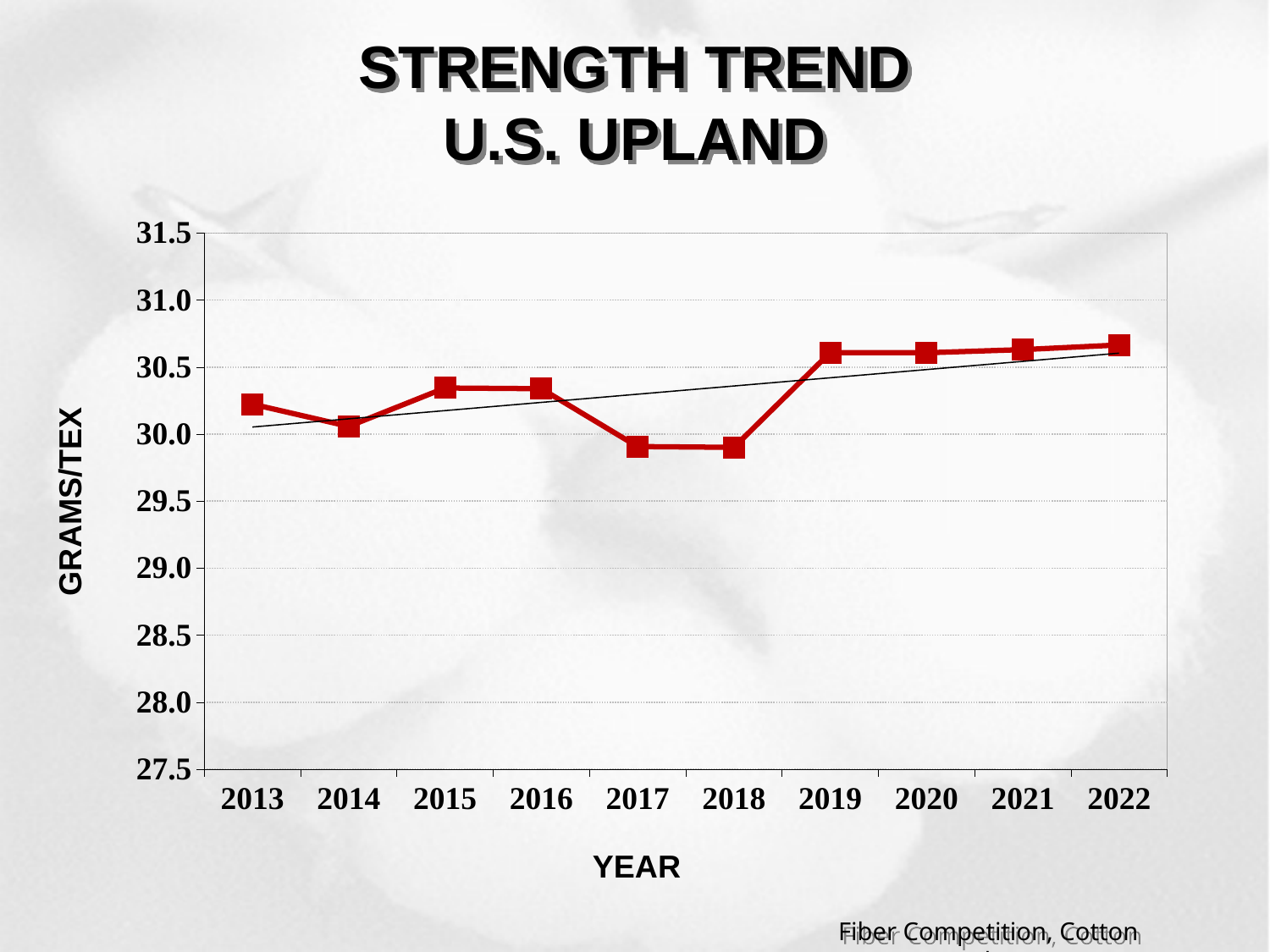
What is the label on the y axis? GRAMS/TEX Is the value for 2019 greater or less than 30.5? greater Which year has the larger value, 2014 or 2019? 2019 Which year has the larger value, 2015 or 2017? 2015 What is the title of the chart? STRENGTH TREND U.S. UPLAND What kind of chart is shown on the slide? line chart Is the value for 2022 greater or less than 30.5? greater Is the value for 2015 greater or less than 30.5? less How many years are plotted on the x axis? 10 Does the overall trend of strength from 2013 to 2022 rise or fall? rise